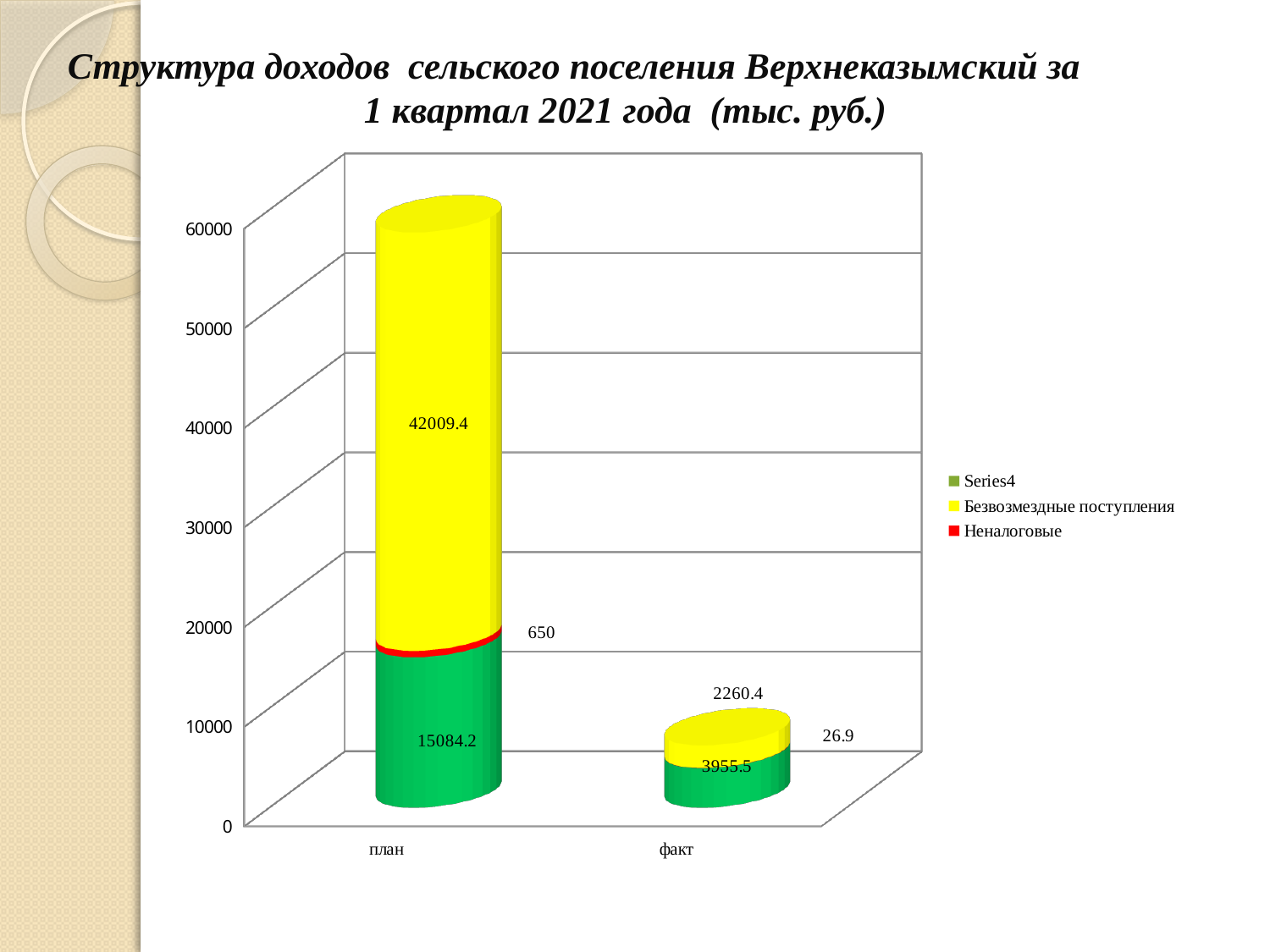
What is the value of Безвозмездные поступления for план? 42009.4 What is the total of the stacked bar for план? 57743.6 What is the difference between Безвозмездные поступления for план and for факт? 39749 Which category has the higher total, план or факт? план What is the value of Series4 for факт? 3955.5 What is the difference between Series4 for план and for факт? 11128.7 What is the value of Неналоговые for план? 650 How many series does the legend list? 3 What kind of chart is shown on the slide? stacked bar chart What is the value of Неналоговые for факт? 26.9 What is the value of Безвозмездные поступления for факт? 2260.4 What is the total of the stacked bar for факт? 6242.8